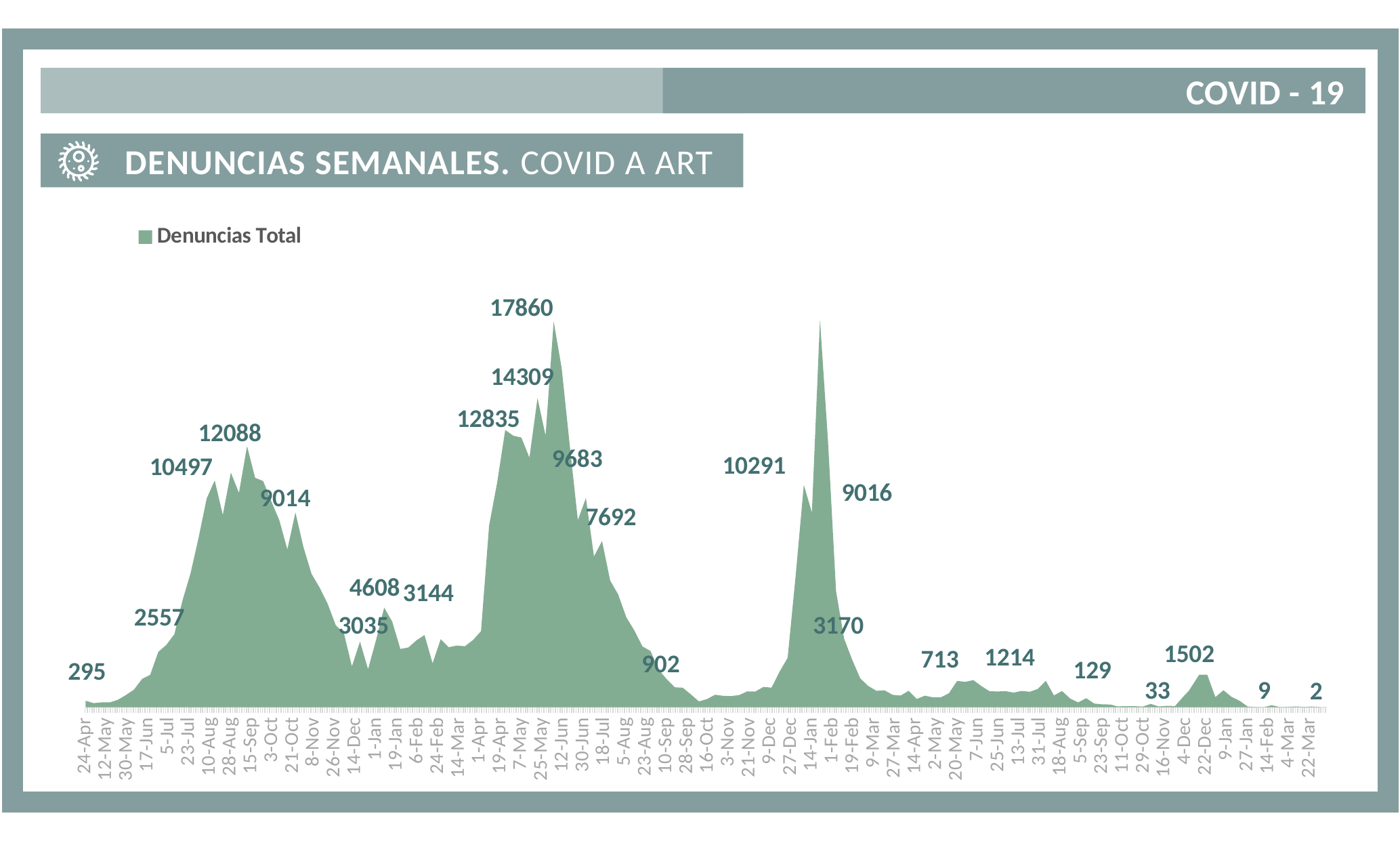
What is the lowest labelled value on the chart? 2 What is the difference between the labelled values 1502 and 1214? 288 Do the values rise or fall along the x axis from the 17860 peak to the 902 label? fall What is the difference between the labelled values 14309 and 12835? 1474 What is the last (rightmost) labelled value on the chart? 2 What is the first (leftmost) labelled value on the chart? 295 Which labelled value is larger, 10291 or 9016? 10291 What kind of chart is shown on the slide? area chart What is the difference between the highest labelled peak (17860) and the labelled peak of the first wave (12088)? 5772 What is the name of the series shown in the legend? Denuncias Total How many series does the legend list? 1 What is the highest labelled value on the chart? 17860